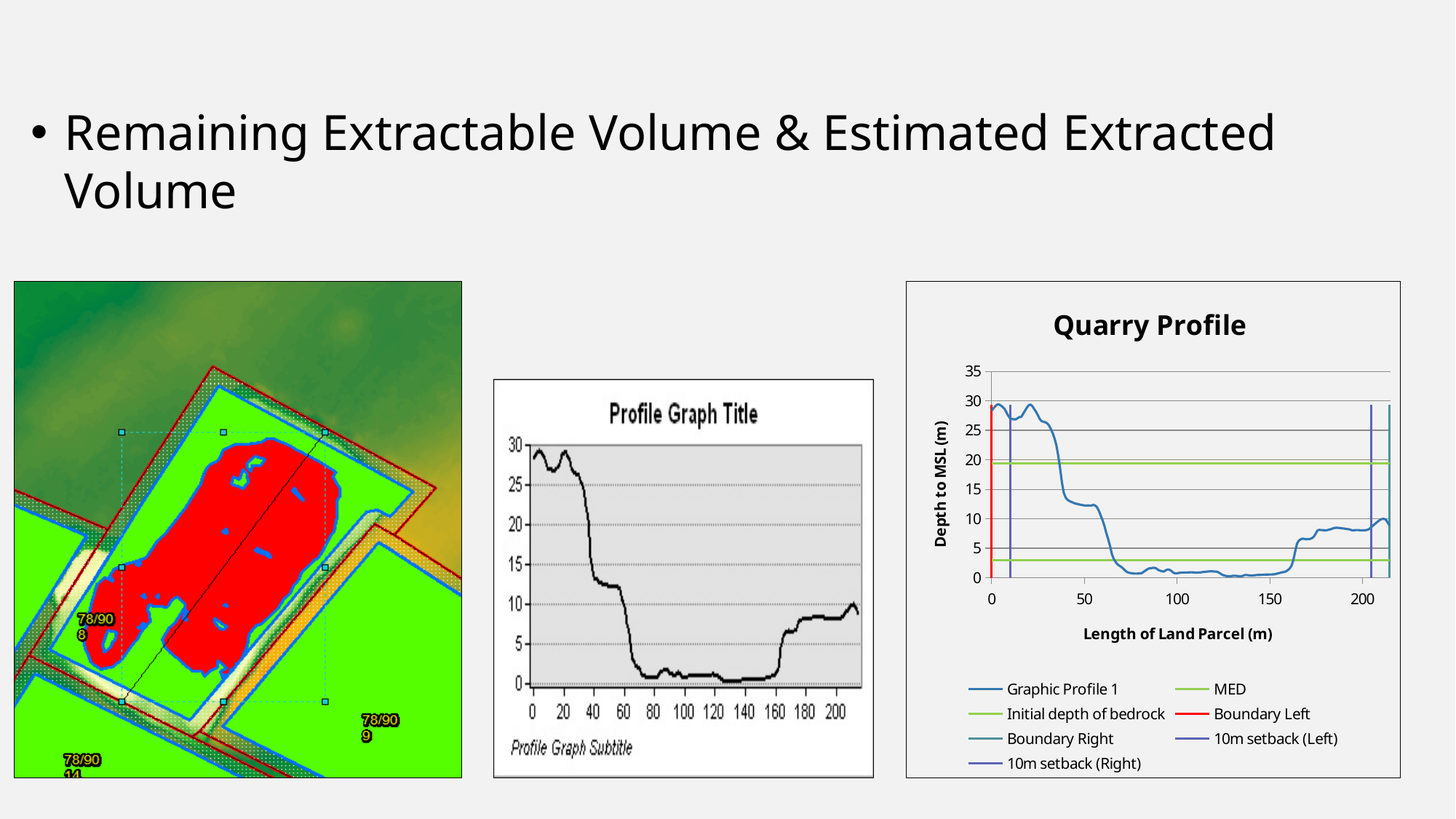
In the Quarry Profile chart, is the MED line greater or less than 15? less What kind of chart is the chart titled Profile Graph Title? line chart In the Quarry Profile chart, is the value of Graphic Profile 1 at a length of 200 m greater or less than 5? greater How many series does the legend of the Quarry Profile chart list? 7 In the Quarry Profile chart, which is larger for Graphic Profile 1: the value at 0 m or the value at 100 m? the value at 0 m What kind of chart is the Quarry Profile chart? line chart What is the x-axis label of the Quarry Profile chart? Length of Land Parcel (m) In the Quarry Profile chart, is the value of Graphic Profile 1 at a length of 100 m greater or less than 5? less In the Quarry Profile chart, does Graphic Profile 1 rise or fall between 0 m and 100 m? fall What is the y-axis label of the Quarry Profile chart? Depth to MSL (m)